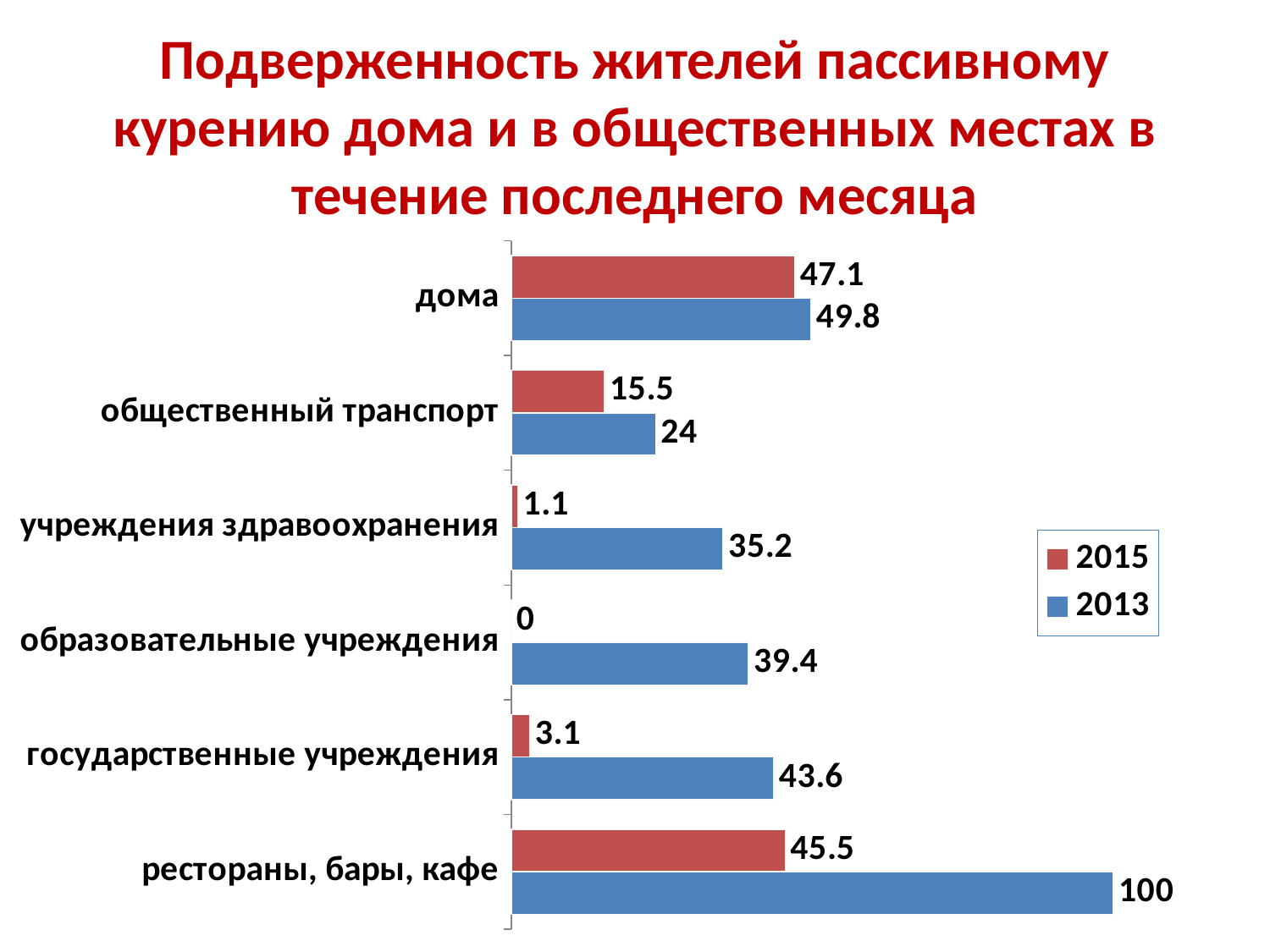
What is the difference between the 2013 and 2015 values for государственные учреждения? 40.5 What is the 2015 value for учреждения здравоохранения? 1.1 Which is larger for дома: the 2013 value or the 2015 value? 2013 Which category has the lowest 2015 value? образовательные учреждения How many series does the legend list? 2 How many categories are shown on the chart? 6 Which colour represents the 2013 series in the legend? blue Which category has the highest 2013 value? рестораны, бары, кафе What is the 2013 value for рестораны, бары, кафе? 100 What is the 2013 value for общественный транспорт? 24 What kind of chart is shown on the slide? bar chart What is the 2015 value for дома? 47.1